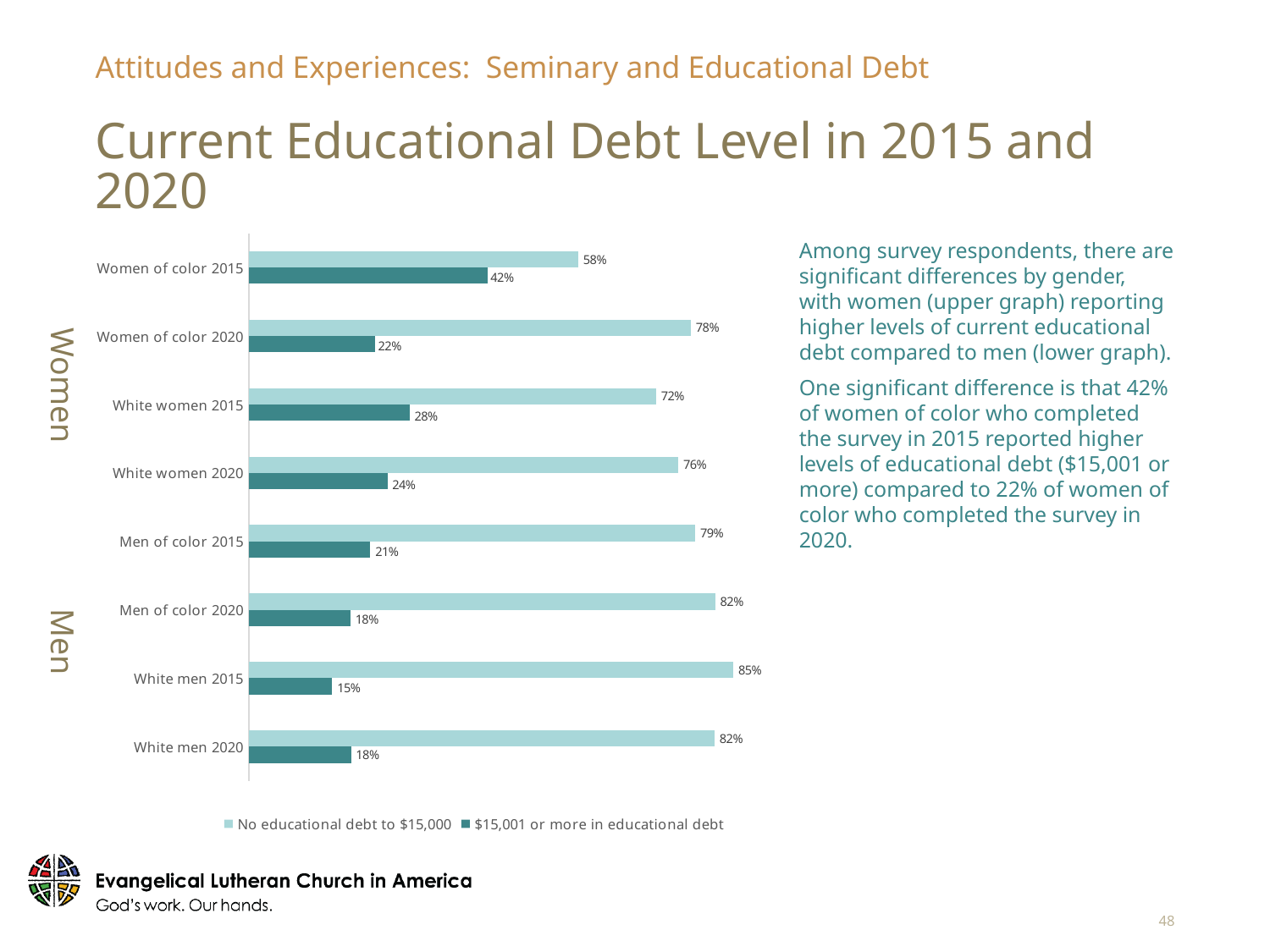
What is the difference between the $15,001 or more in educational debt values for women of color in 2015 and women of color in 2020? 20% Which is larger: the no educational debt to $15,000 value for men of color 2015 or for white women 2015? Men of color 2015 What percentage of white women in 2020 reported $15,001 or more in educational debt? 24% How many categories are shown on the chart? 8 Which category has the lowest value for $15,001 or more in educational debt? White men 2015 What is the total of the two values for white women 2015? 100% What percentage of women of color in 2015 reported $15,001 or more in educational debt? 42% How many series does the legend list? 2 Which category has the highest value for $15,001 or more in educational debt? Women of color 2015 What kind of chart is shown on the slide? Bar chart Which series is shown in the darker teal colour? $15,001 or more in educational debt What percentage of white men in 2015 reported no educational debt to $15,000? 85%